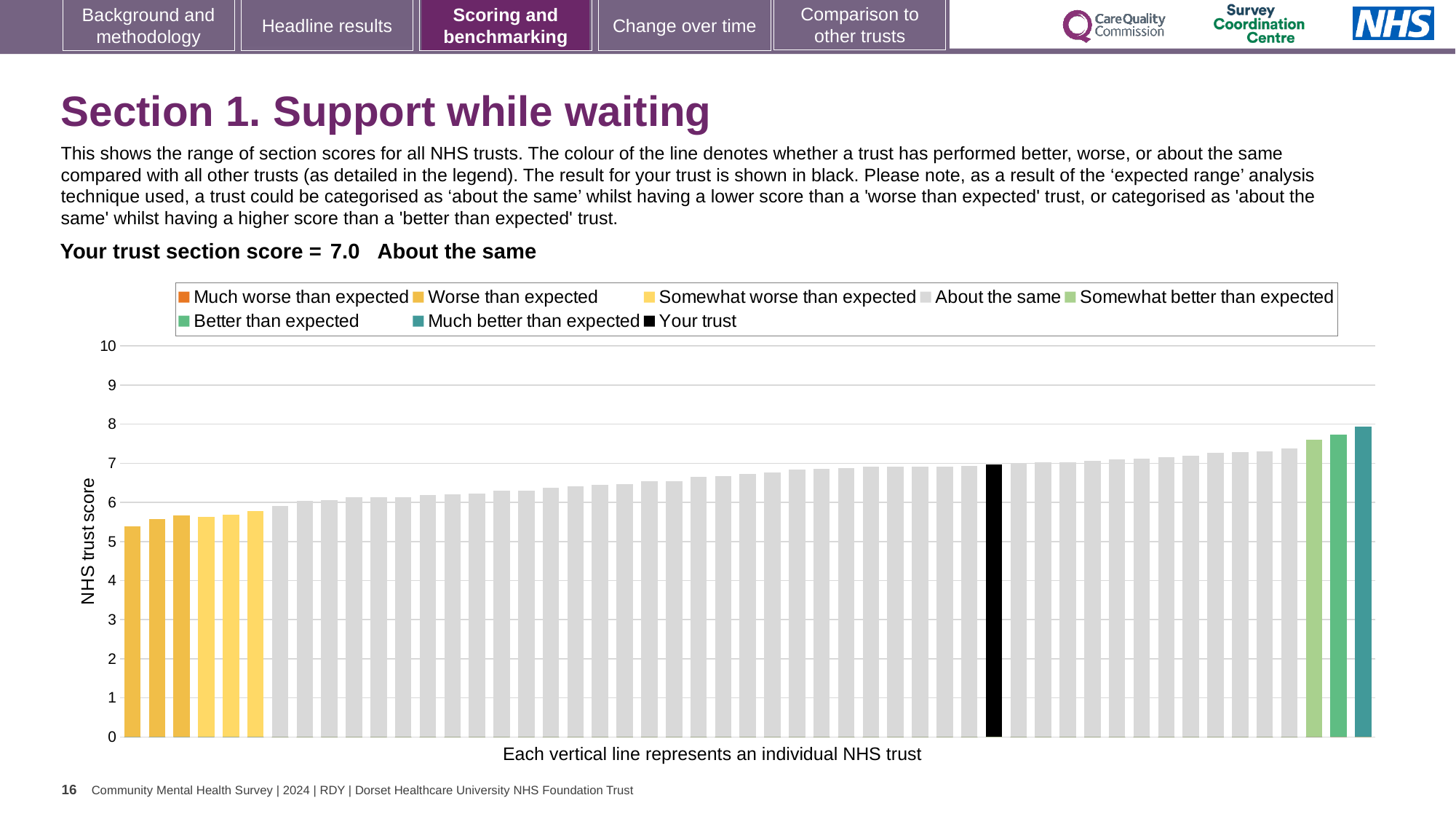
How many bars are coloured in the 'Worse than expected' yellow shade at the left of the chart? 3 Which performance category is your trust placed in for this section? About the same What is the label on the vertical axis of the chart? NHS trust score What colour is the bar representing your trust? black Do the bar values rise or fall from left to right across the chart? rise Which legend category does the highest bar in the chart belong to? Much better than expected How many entries does the chart legend list? 8 Is the value of the black 'Your trust' bar greater or less than 5? greater What kind of chart is shown on the slide? bar chart Is the value of the lowest bar in the chart greater or less than 6? less Is the value of the highest bar in the chart greater or less than 7? greater What is the section score for your trust shown on the slide? 7.0